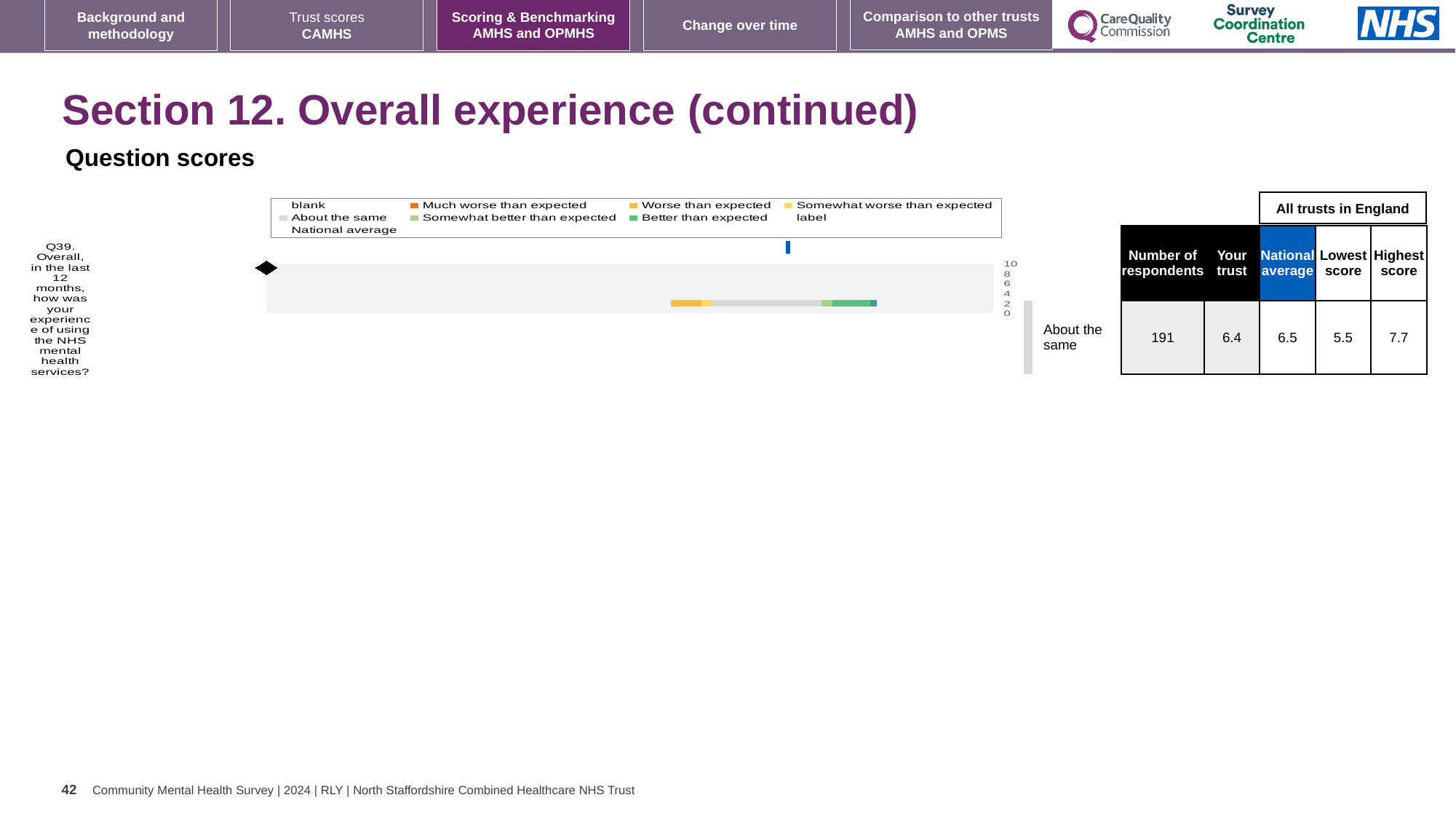
What is the highest score among all trusts in England for Q39? 7.7 What kind of chart is shown under 'Question scores'? bar chart What is the 'Your trust' score for Q39? 6.4 Which question number is plotted in the chart? Q39 Which is larger for Q39, the 'Your trust' score or the national average? National average How many respondents answered Q39? 191 How many survey questions are plotted in the chart? 1 What is the national average score for Q39? 6.5 Which benchmark category is shown for Q39 next to the chart? About the same What is the lowest score among all trusts in England for Q39? 5.5 What is the difference between the highest score and the lowest score for Q39? 2.2